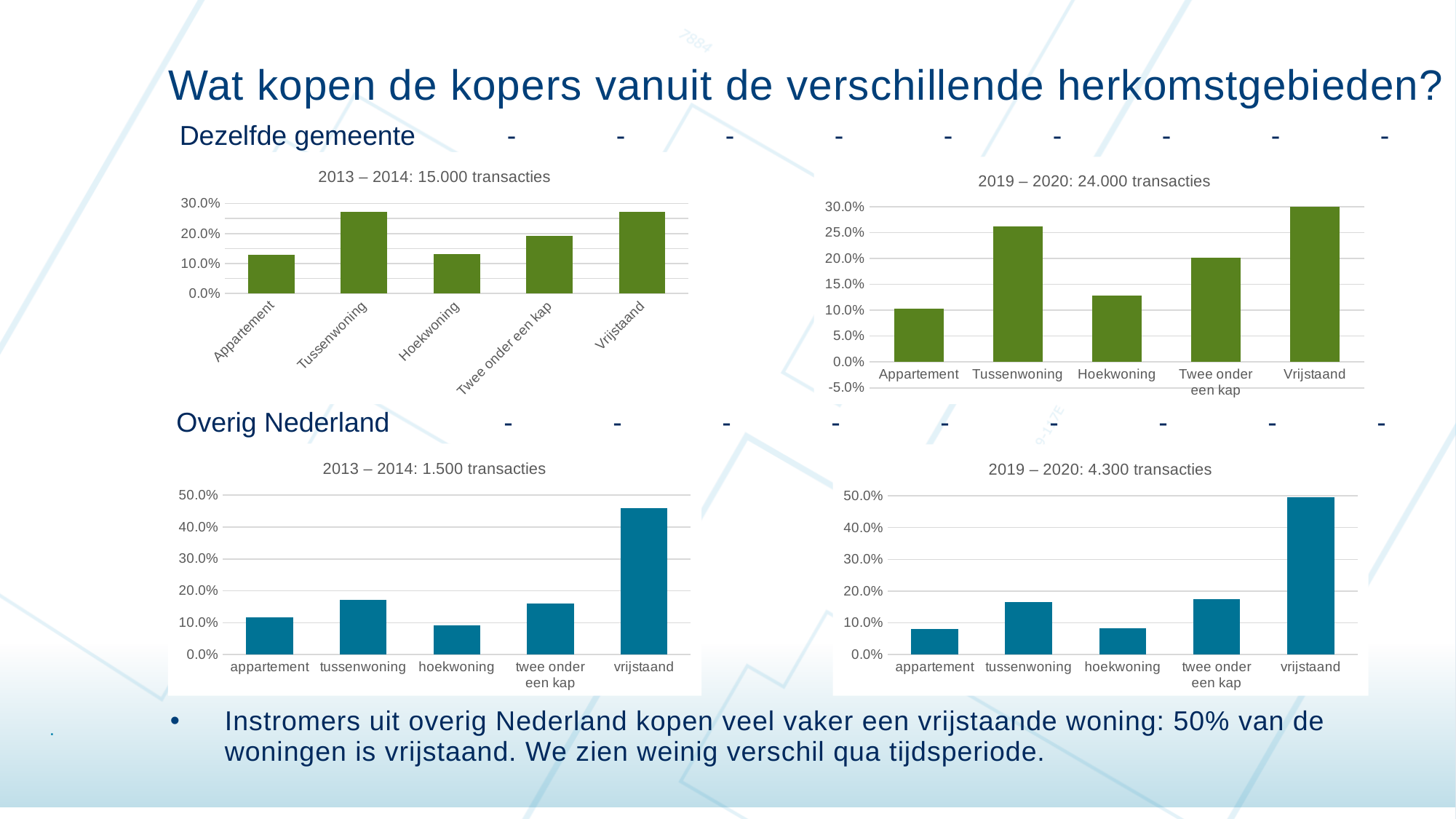
In the chart titled "2019 – 2020: 4.300 transacties" (bottom right), is the value for appartement greater or less than 10.0%? less In the chart titled "2013 – 2014: 1.500 transacties" (bottom left), is the value for vrijstaand greater or less than 40.0%? greater In the chart titled "2019 – 2020: 24.000 transacties" (top right), which category has the highest value? Vrijstaand In the chart titled "2013 – 2014: 1.500 transacties" (bottom left), which category has the highest value? vrijstaand In the chart titled "2019 – 2020: 24.000 transacties" (top right), which is larger: Tussenwoning or Twee onder een kap? Tussenwoning In the chart titled "2019 – 2020: 24.000 transacties" (top right), is the value for Vrijstaand greater or less than 25.0%? greater What kind of chart is the chart titled "2019 – 2020: 4.300 transacties" (bottom right)? Bar chart In the chart titled "2019 – 2020: 24.000 transacties" (top right), which category has the lowest value? Appartement How many categories are shown in the chart titled "2013 – 2014: 15.000 transacties" (top left)? 5 In the chart titled "2013 – 2014: 15.000 transacties" (top left), is the value for Tussenwoning larger or smaller than the value for Hoekwoning? larger In the chart titled "2013 – 2014: 1.500 transacties" (bottom left), which category has the lowest value? hoekwoning In the chart titled "2019 – 2020: 4.300 transacties" (bottom right), which category has the highest value? vrijstaand